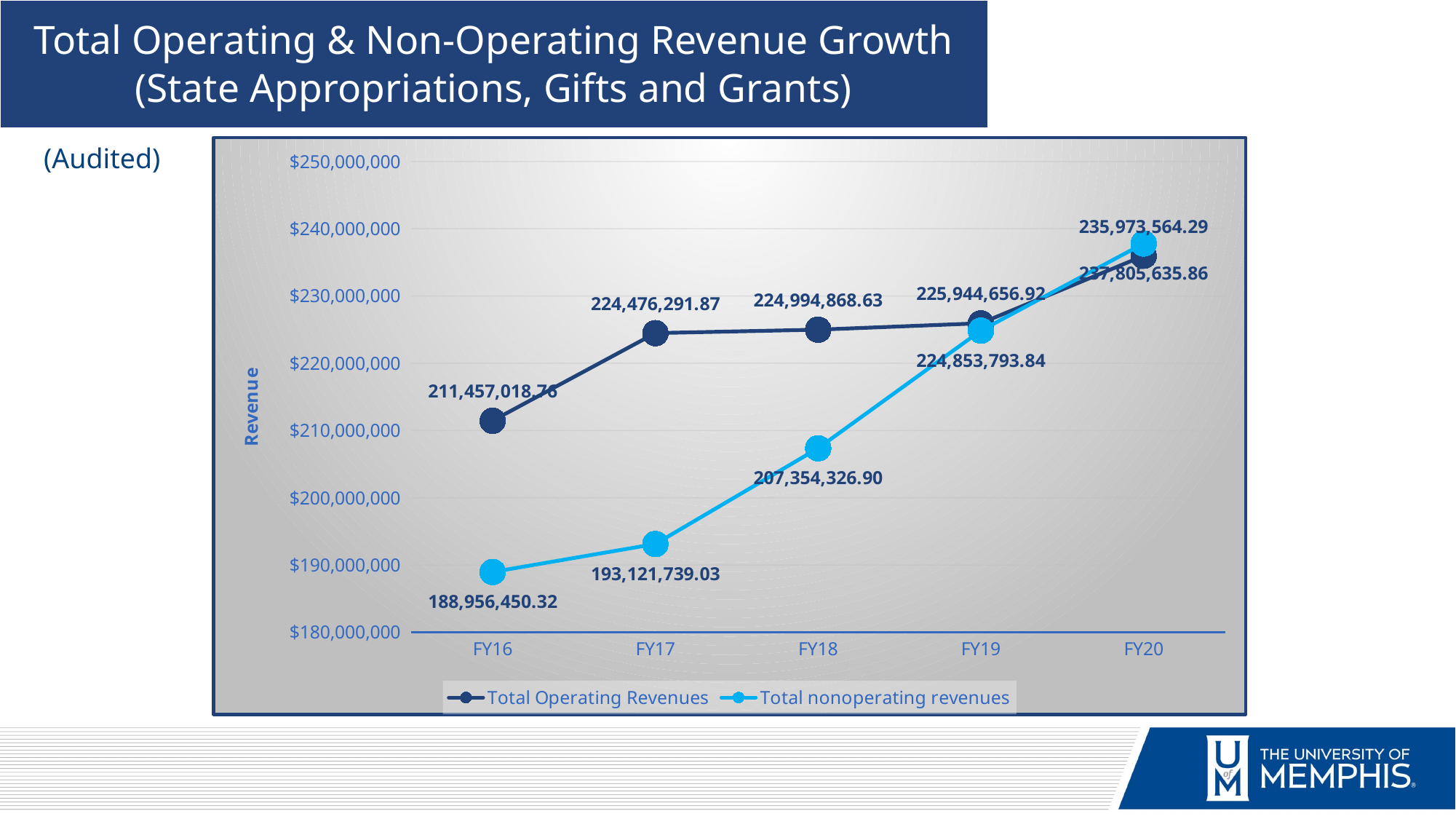
Is the value of Total nonoperating revenues for FY17 greater or less than $200,000,000? less How many series does the legend list? 2 What is the difference between Total Operating Revenues and Total nonoperating revenues in FY16? 22,500,568.44 How many fiscal years are plotted on the x axis? 5 What is the value of Total nonoperating revenues for FY16? 188,956,450.32 What is the value of Total Operating Revenues for FY19? 225,944,656.92 What is the value of Total nonoperating revenues for FY18? 207,354,326.90 What is the value of Total Operating Revenues for FY16? 211,457,018.76 In FY17, which is larger: Total Operating Revenues or Total nonoperating revenues? Total Operating Revenues Do Total nonoperating revenues rise or fall from FY16 to FY20? rise In which fiscal year are Total nonoperating revenues lowest? FY16 What kind of chart is shown on the slide? line chart